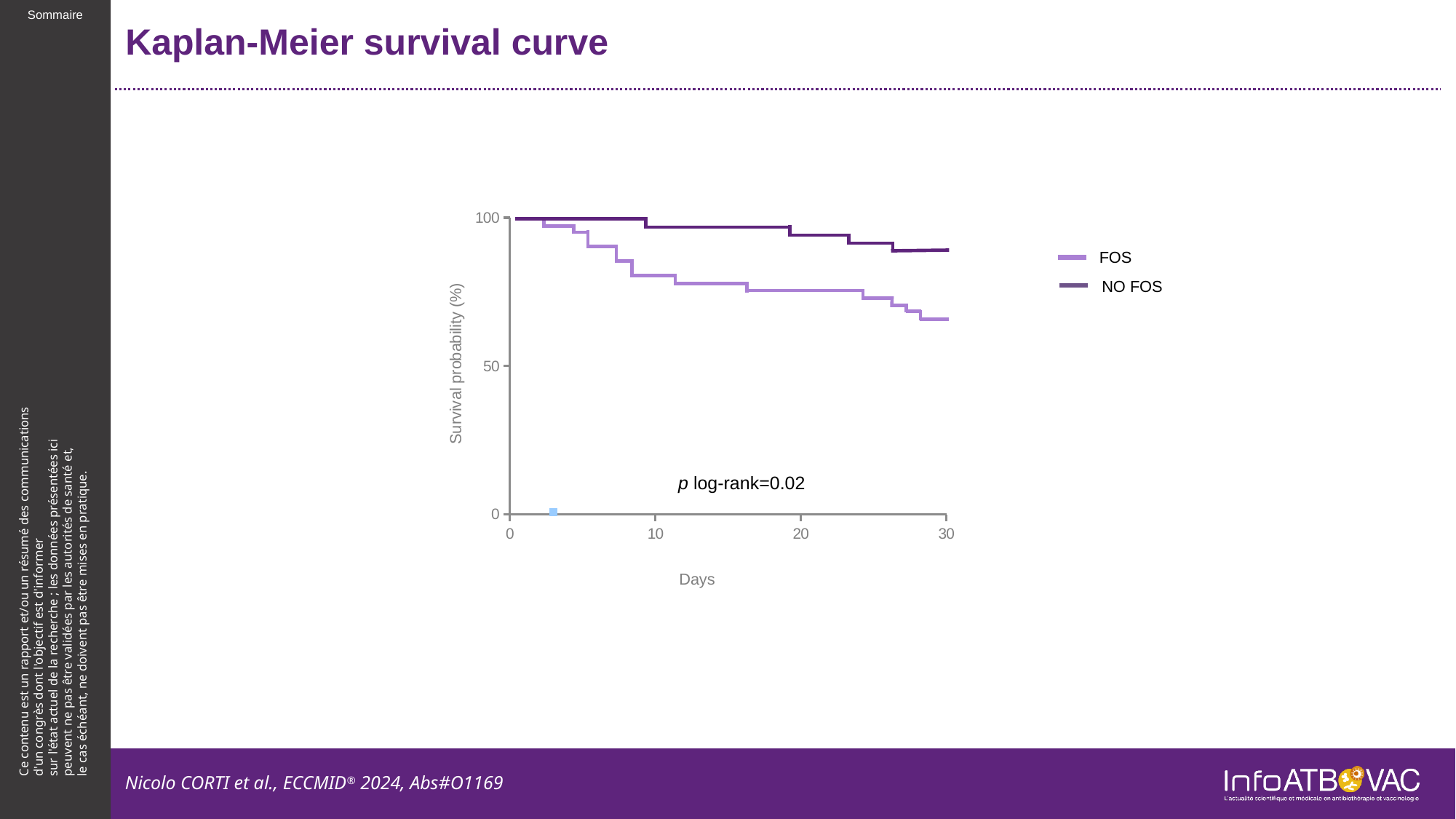
Which two groups are listed in the chart legend? FOS and NO FOS Do the survival probability curves rise or fall as the number of days increases? Fall Which group has the lower survival probability at the end of the 30-day follow-up? FOS What kind of chart is shown on the slide? Line chart (Kaplan-Meier survival curve) Is the survival probability for FOS at day 30 greater or less than 50? greater Is the survival probability for FOS at day 30 greater or less than 100? less What is the title of the chart on the slide? Kaplan-Meier survival curve What is the label of the x axis of the chart? Days What is the p log-rank value printed on the chart? 0.02 At day 30, which group has the higher survival probability, FOS or NO FOS? NO FOS How many series does the legend list? 2 Is the survival probability for NO FOS at day 30 greater or less than 50? greater